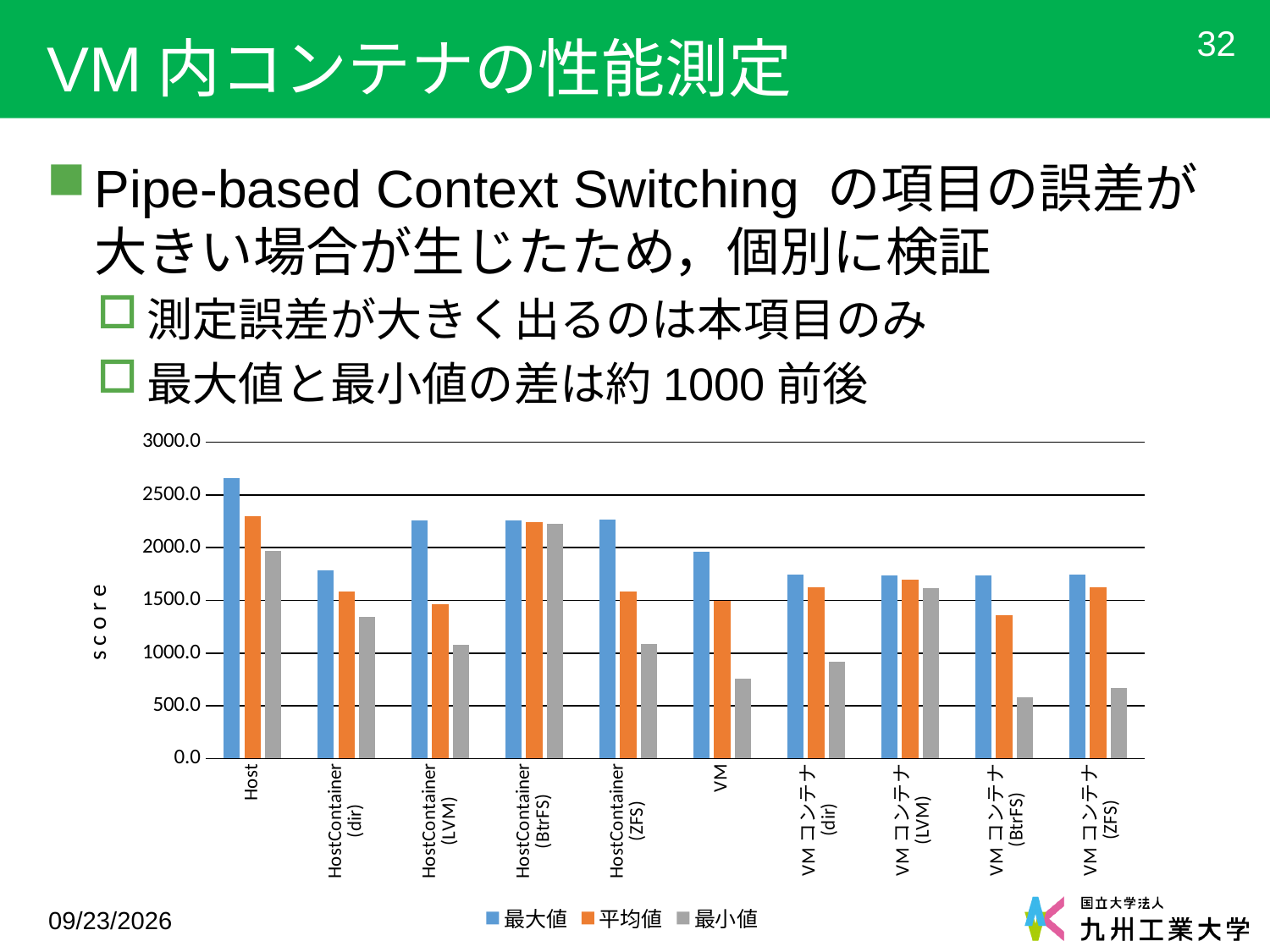
Which category has the highest 最大値 bar in the chart? Host Is the 最小値 value for HostContainer (dir) greater or less than 1500? less Is the 最大値 value for Host greater or less than 2500? greater What kind of chart is shown on the slide? bar chart Is the 最小値 value for HostContainer (BtrFS) greater or less than 2000? greater How many series does the chart legend list? 3 How many categories are shown along the x axis of the chart? 10 What is the label on the vertical axis of the chart? score Which category has the lowest 最小値 bar in the chart? VM コンテナ (BtrFS) Which has the larger 最小値 value: HostContainer (BtrFS) or HostContainer (ZFS)? HostContainer (BtrFS) Which series is shown in orange in the chart legend? 平均値